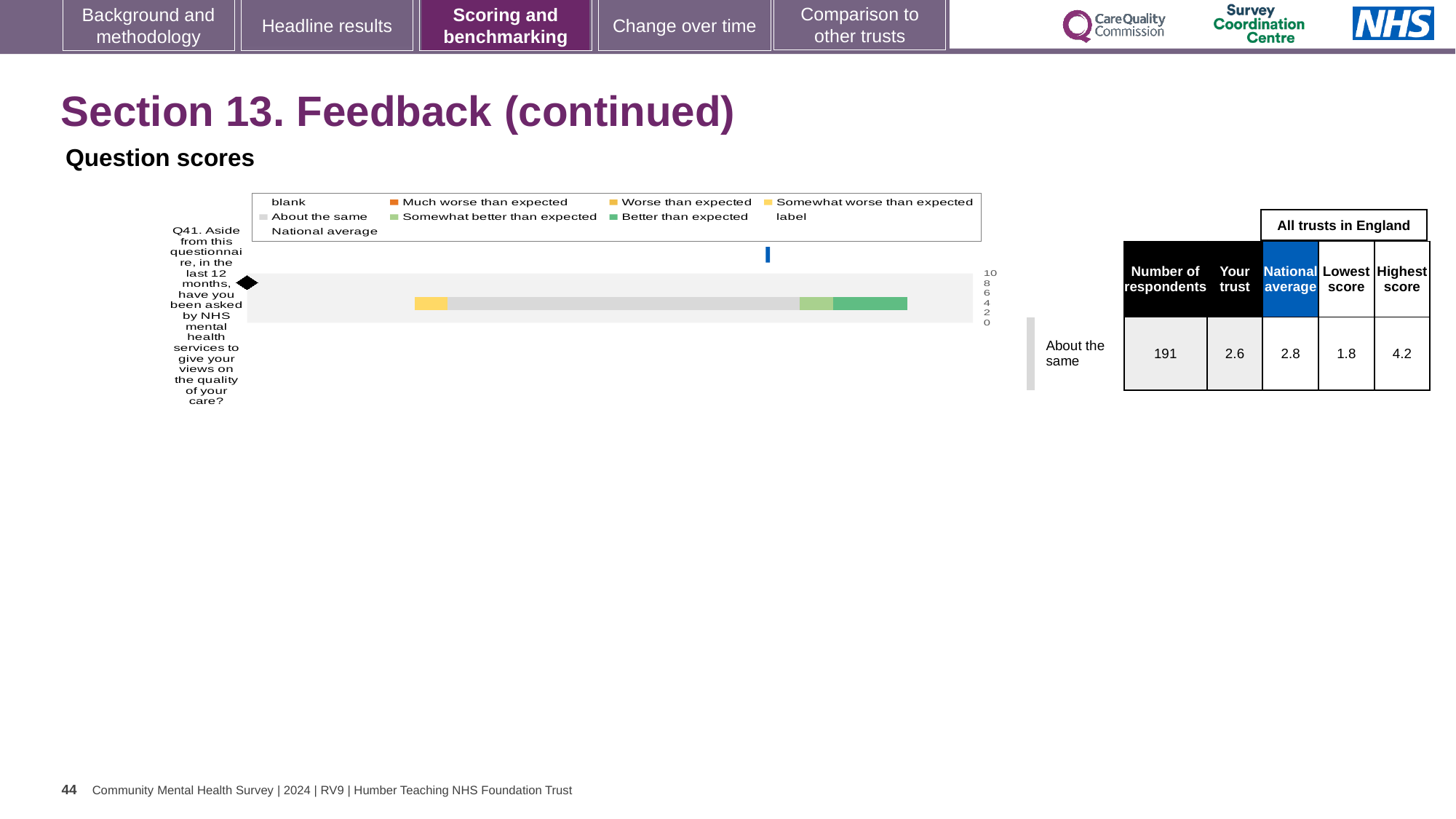
What is the national average score for Q41? 2.8 What is the lowest score among all trusts in England for Q41? 1.8 How many respondents answered Q41? 191 What is the difference between the highest and lowest scores for Q41? 2.4 What benchmark category is shown for Q41 next to the chart? About the same How many entries does the chart's legend list? 9 Which question number is plotted in the chart? Q41 Which is larger for Q41, the 'Your trust' score or the national average? National average What is the 'Your trust' score for Q41? 2.6 What is the highest score among all trusts in England for Q41? 4.2 What kind of chart is shown on the slide? bar chart How many questions (categories) are plotted in the chart? 1